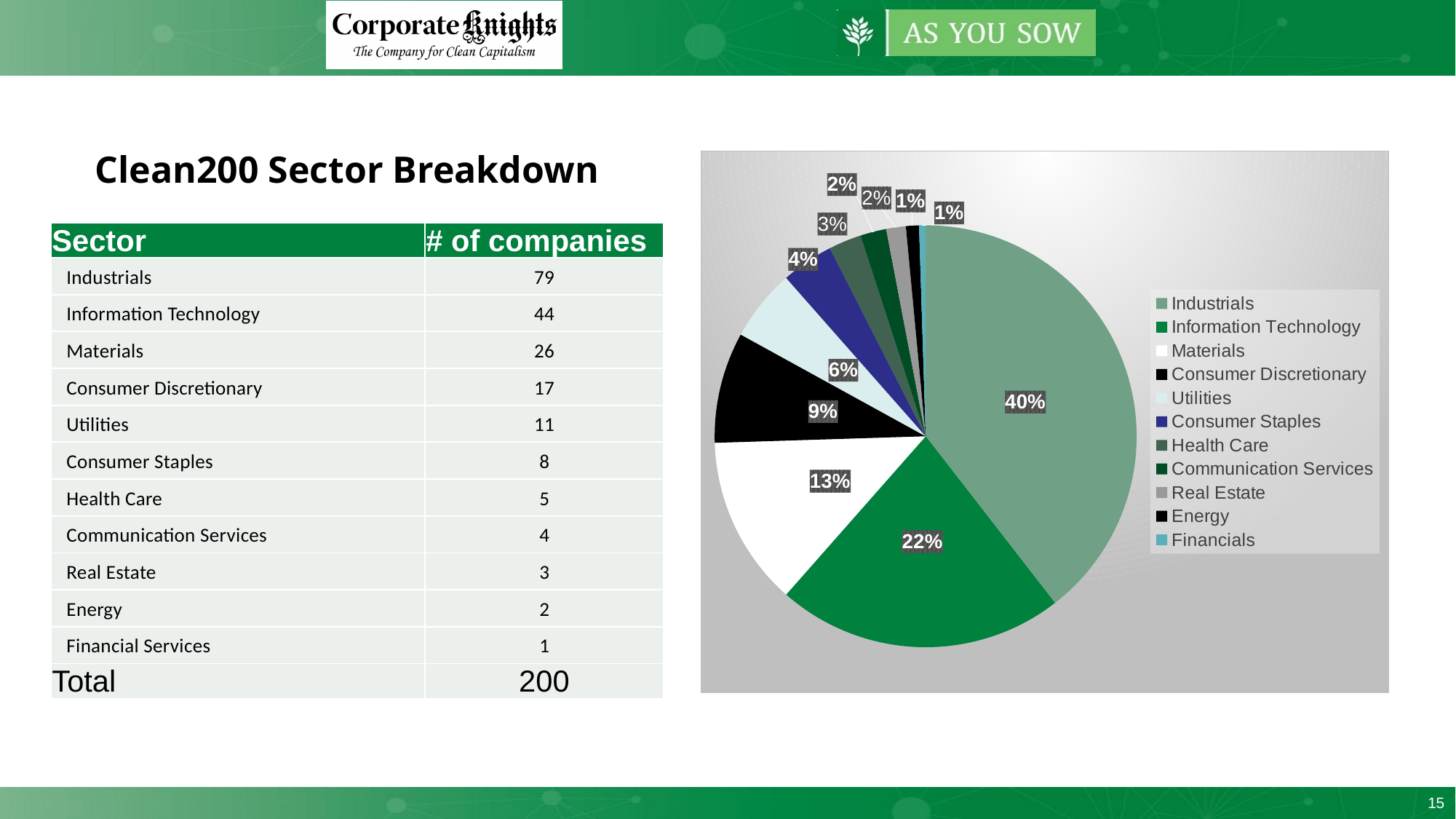
What share of the pie does Consumer Discretionary represent? 9% What share of the pie does Information Technology represent? 22% Which slice is larger, Materials or Consumer Discretionary? Materials What share of the pie does Industrials represent? 40% What is the difference in percentage points between the Industrials slice and the Information Technology slice? 18 percentage points Which legend entry is shown in white in the pie chart? Materials How many slices does the pie chart have? 11 How many entries does the legend of the pie chart list? 11 What type of chart is shown on the slide? pie chart Which sector has the largest slice of the pie? Industrials